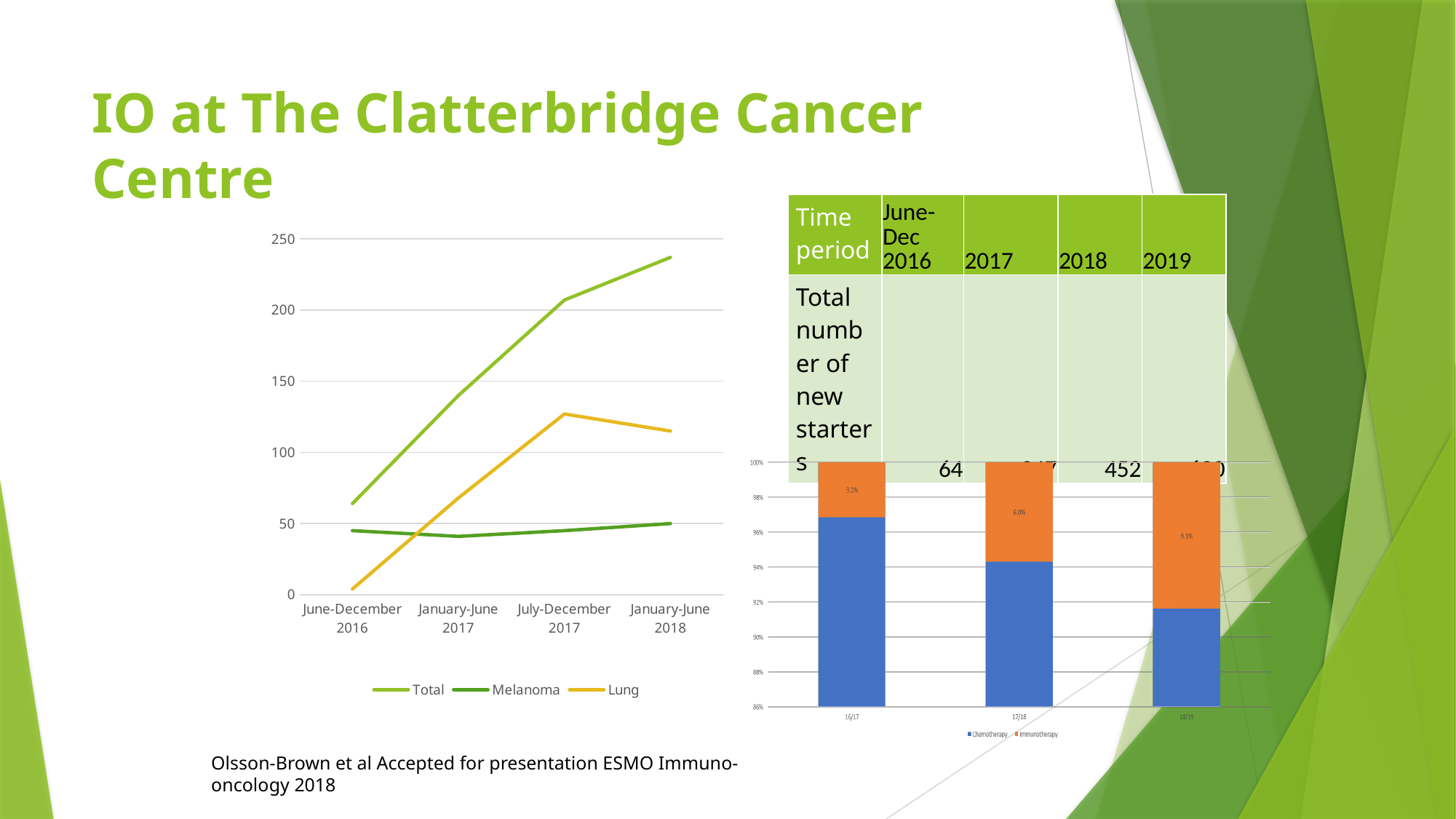
In the line chart on the left, is the Lung value for June-December 2016 greater or less than 50? less In the line chart on the left, in which period is the Total series highest? January-June 2018 In the line chart on the left, does the Total series rise or fall from June-December 2016 to January-June 2018? rise What type of chart is the chart on the left of the slide? line chart In the stacked bar chart on the right, what is the Immunotherapy value for 17/18? 6.0% In the stacked bar chart on the right, how many series does the legend list? 2 In the stacked bar chart on the right, what is the difference between the Immunotherapy values for 18/19 and 16/17? 5.9% In the line chart on the left, in which period is the Lung series highest? July-December 2017 In the stacked bar chart on the right, which year has the highest Immunotherapy value? 18/19 In the line chart on the left, how many time periods are shown on the x axis? 4 In the line chart on the left, is the Total value for January-June 2018 greater or less than 200? greater In the line chart on the left, how many series does the legend list? 3